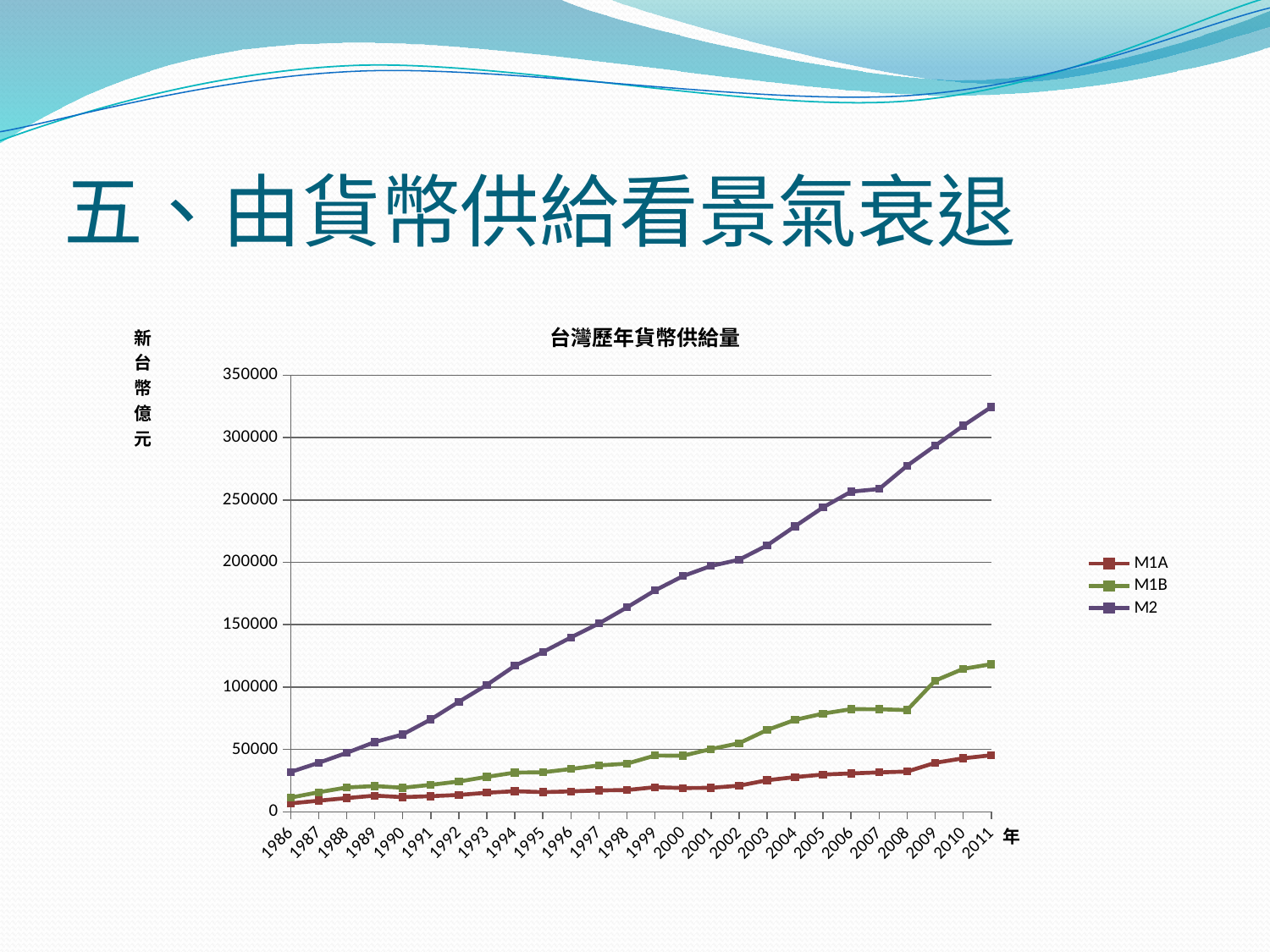
Is the value for M2 in 2011 greater or less than 300000? greater Is the value for M2 in 1986 greater or less than 50000? less How many series does the legend list? 3 What kind of chart is shown on the slide? line chart Which is larger in 2011, M1B or M1A? M1B How many years are plotted along the x axis? 26 Which series has the lowest value in 2011? M1A Does the M2 series rise or fall from 1986 to 2011? rise Is the value for M1A in 2011 greater or less than 50000? less Which series has the highest value in 2011? M2 What is the title of the chart? 台灣歷年貨幣供給量